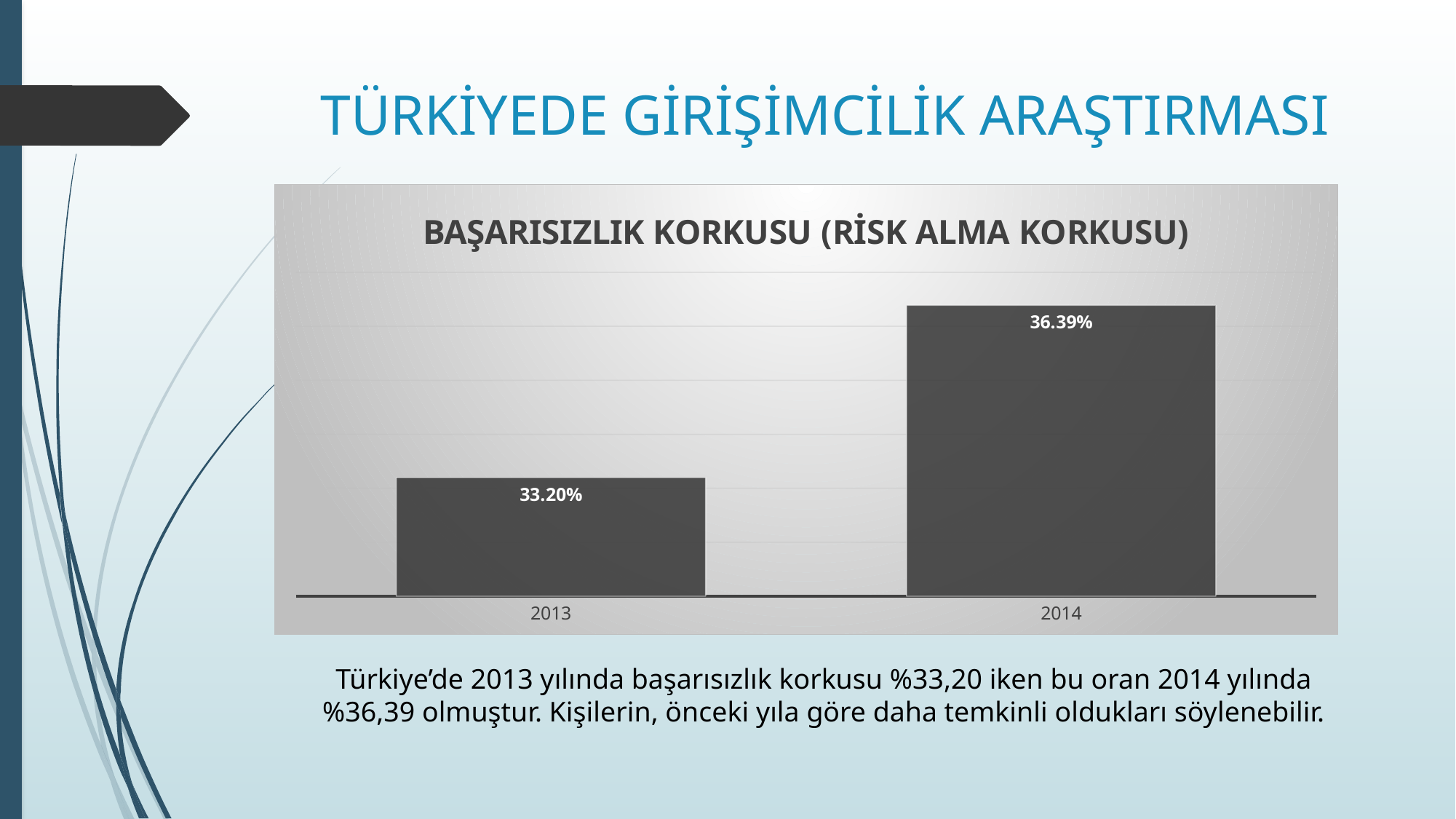
Which year has the highest value? 2014 How many categories are shown on the x axis? 2 What is the title of the chart? BAŞARISIZLIK KORKUSU (RİSK ALMA KORKUSU) Which is larger, the value for 2013 or the value for 2014? 2014 Do the values rise or fall from 2013 to 2014? rise What kind of chart is shown on the slide? bar chart What is the value for 2013? 33.20% What is the value for 2014? 36.39% What colour are the bars in the chart? dark grey Which year has the lowest value? 2013 What is the difference between the values for 2014 and 2013? 3.19%